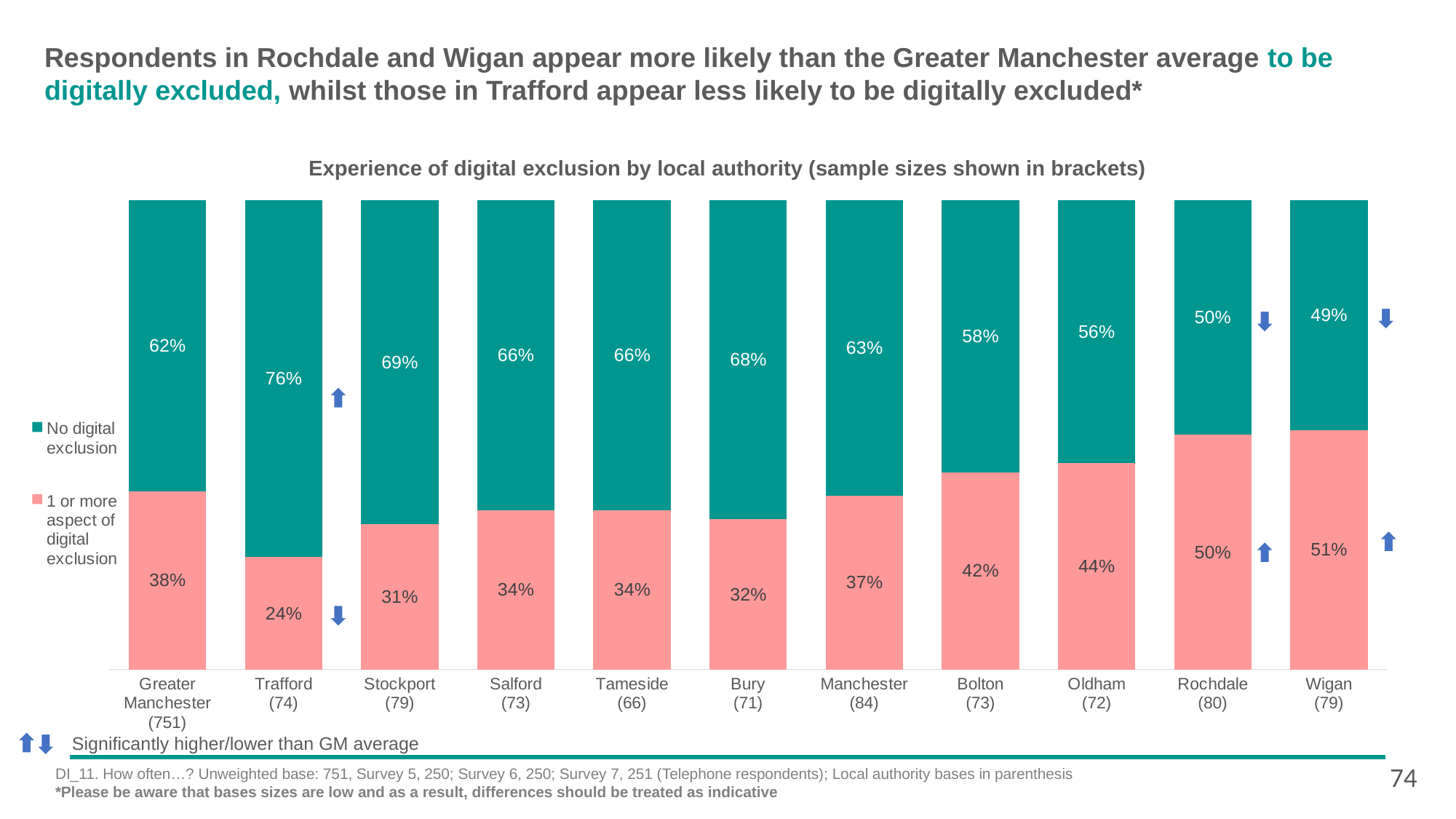
What is the sample size shown in brackets for Manchester? 84 What percentage of respondents in Wigan reported no digital exclusion? 49% How many series does the legend list? 2 What is the difference between the 1 or more aspect of digital exclusion values for Rochdale and Greater Manchester? 12 percentage points What is the value for 1 or more aspect of digital exclusion for Greater Manchester? 38% How many local authority categories are shown on the x axis, including Greater Manchester? 11 Which local authority has the lowest percentage reporting 1 or more aspect of digital exclusion? Trafford Which local authority has the highest percentage reporting no digital exclusion? Trafford What kind of chart is shown on the slide? Stacked bar chart Which has a larger share reporting 1 or more aspect of digital exclusion, Oldham or Bury? Oldham What percentage of respondents in Trafford reported 1 or more aspect of digital exclusion? 24% Which local authority has the highest percentage reporting 1 or more aspect of digital exclusion? Wigan